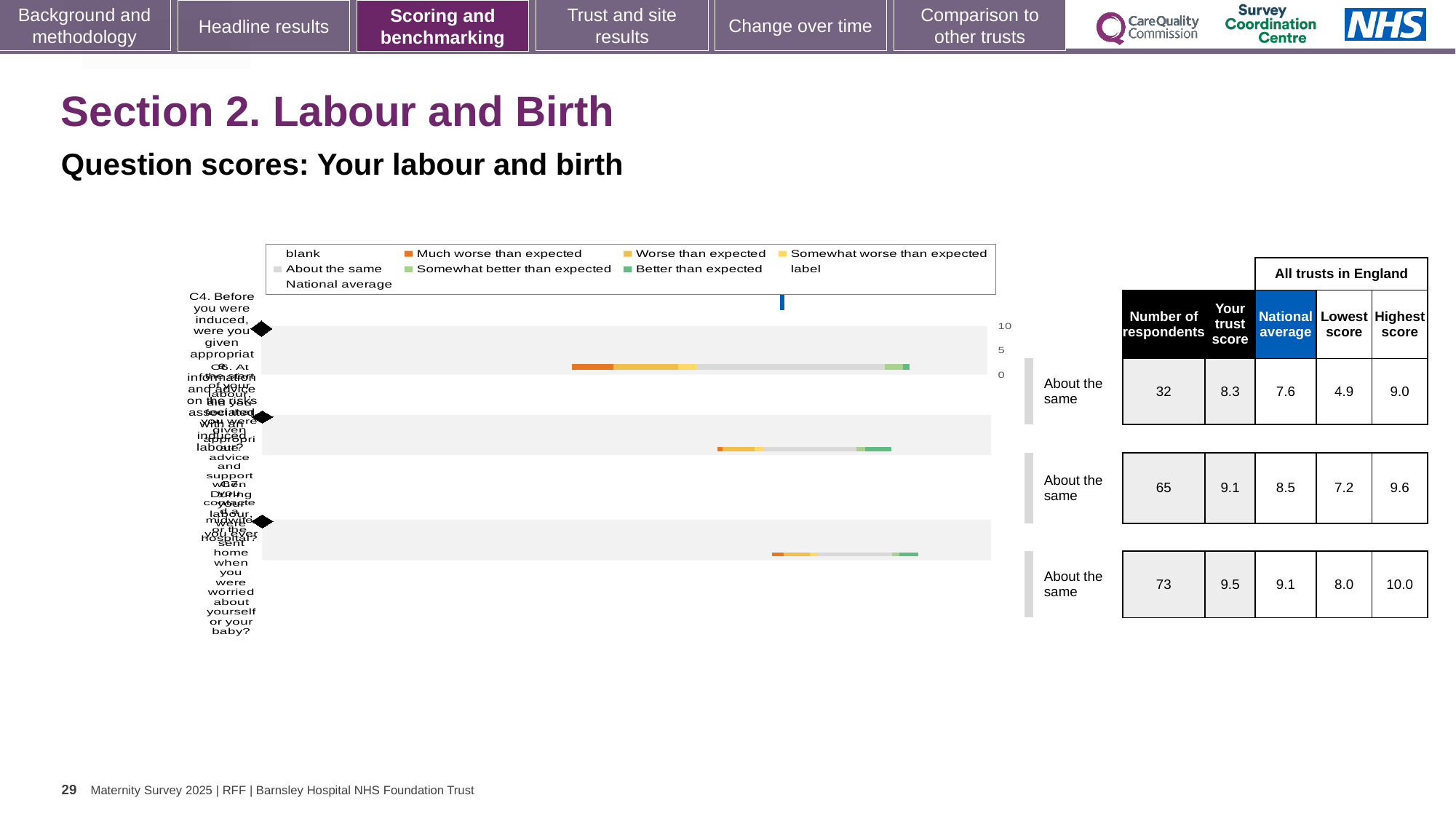
Which legend entry is shown in orange in the chart? Much worse than expected How many entries does the chart legend list? 9 Which legend entry is shown in dark green in the chart? Better than expected How many question bars are plotted in the chart? 3 What benchmark category is shown next to each of the three bars in the chart? About the same What kind of chart is shown on the slide? bar chart